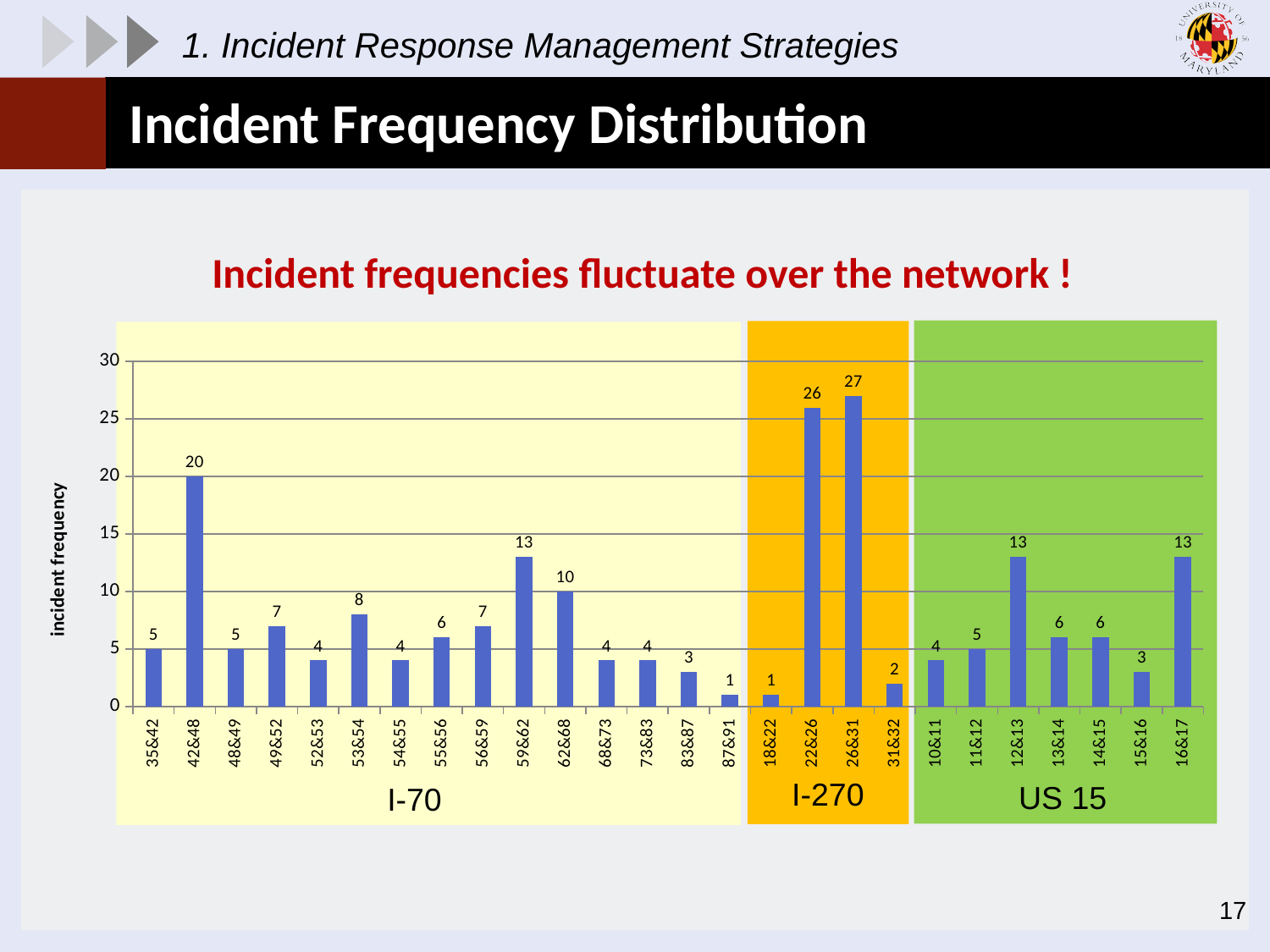
How many segments (bars) are plotted in the chart? 26 Which three roads are the segments grouped under in the chart? I-70, I-270, US 15 What is the incident frequency for the 12&13 segment on US 15? 13 What is the incident frequency for the 26&31 segment on I-270? 27 Is the incident frequency for the 22&26 segment greater or less than 25? greater What is the label of the vertical axis? incident frequency Which has a higher incident frequency, segment 59&62 or segment 62&68? 59&62 What is the incident frequency for the 42&48 segment? 20 What is the difference in incident frequency between the 26&31 and 22&26 segments? 1 What is the difference in incident frequency between the 42&48 and 59&62 segments? 7 What type of chart is shown on the slide? Bar chart Which segment has the highest incident frequency? 26&31